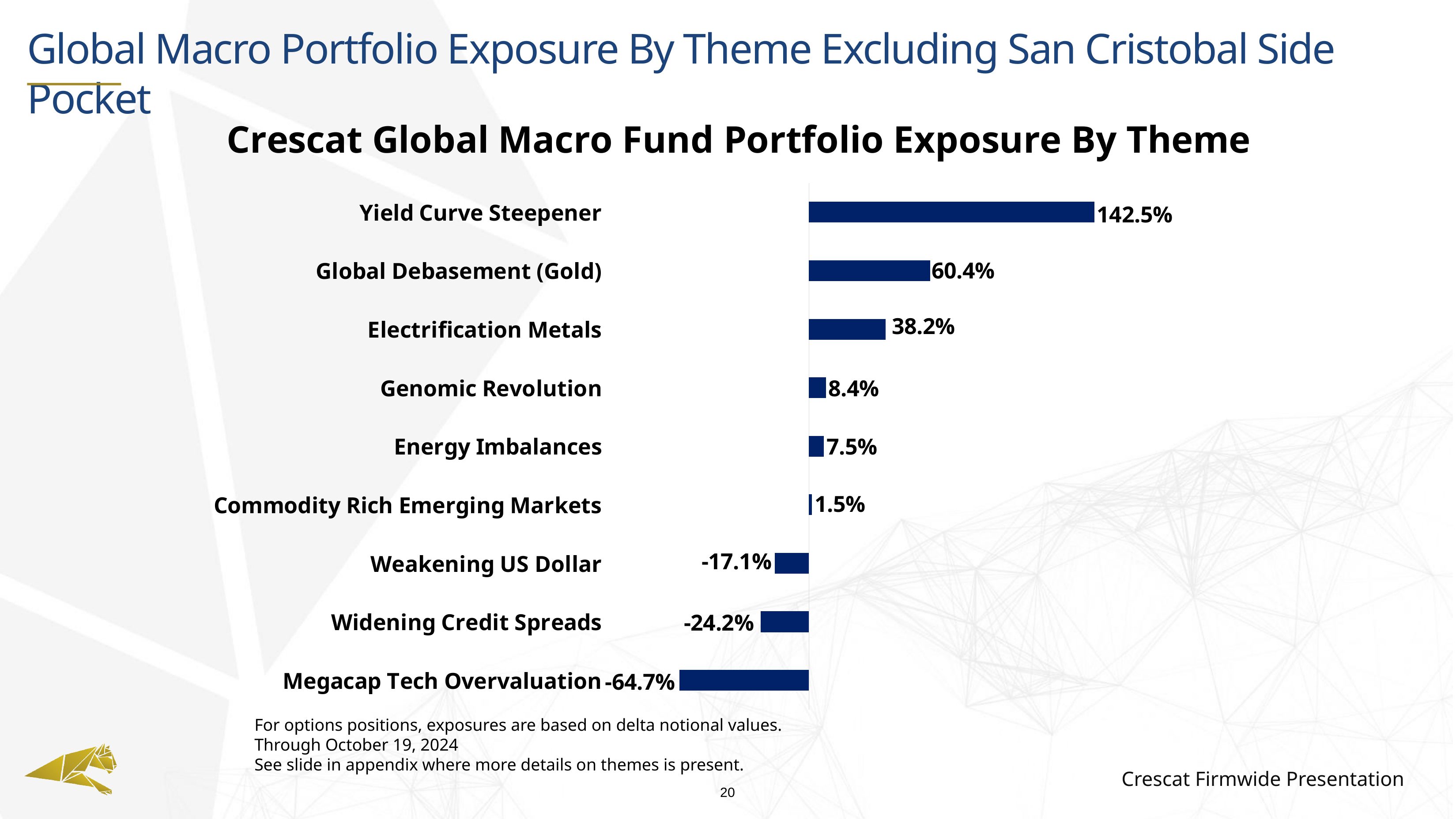
What is the title of the chart? Crescat Global Macro Fund Portfolio Exposure By Theme What is the difference between the exposures for Global Debasement (Gold) and Electrification Metals? 22.2% What is the exposure for Global Debasement (Gold)? 60.4% How many themes are shown in the chart? 9 What is the exposure for Yield Curve Steepener? 142.5% Which has a larger exposure, Genomic Revolution or Energy Imbalances? Genomic Revolution Which theme has the lowest exposure? Megacap Tech Overvaluation How many themes have a negative exposure? 3 What is the exposure for Commodity Rich Emerging Markets? 1.5% What is the exposure for Megacap Tech Overvaluation? -64.7% Which theme has the highest exposure? Yield Curve Steepener What kind of chart is shown on the slide? Bar chart